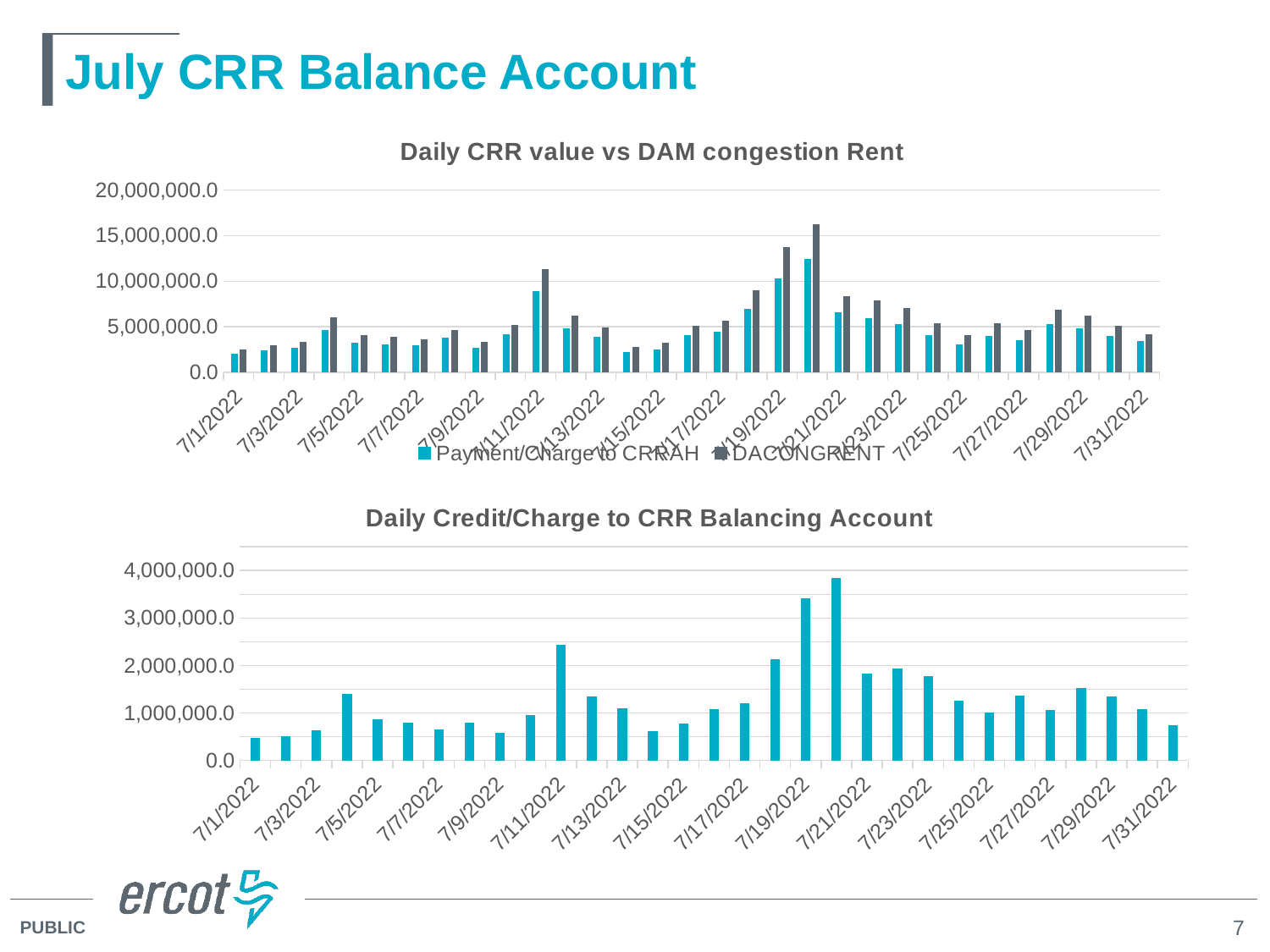
In the 'Daily Credit/Charge to CRR Balancing Account' chart, is the value for 7/1/2022 greater or less than 1,000,000.0? less How many dates are plotted on the x axis of the 'Daily Credit/Charge to CRR Balancing Account' chart? 31 In the 'Daily CRR value vs DAM congestion Rent' chart, is the DACONGRENT value for 7/21/2022 greater or less than 15,000,000.0? less How many series does the legend of the 'Daily CRR value vs DAM congestion Rent' chart list? 2 What kind of chart is the 'Daily Credit/Charge to CRR Balancing Account' chart? bar chart In the 'Daily Credit/Charge to CRR Balancing Account' chart, which date has the highest value? 7/20/2022 In the 'Daily Credit/Charge to CRR Balancing Account' chart, is the value for 7/21/2022 greater or less than 3,000,000.0? less In the 'Daily Credit/Charge to CRR Balancing Account' chart, which is larger, the value for 7/20/2022 or 7/21/2022? 7/20/2022 What are the two series named in the legend of the 'Daily CRR value vs DAM congestion Rent' chart? Payment/Charge to CRRAH and DACONGRENT In the 'Daily CRR value vs DAM congestion Rent' chart, which date has the highest DACONGRENT value? 7/20/2022 In the 'Daily CRR value vs DAM congestion Rent' chart, which series is larger on 7/21/2022, Payment/Charge to CRRAH or DACONGRENT? DACONGRENT